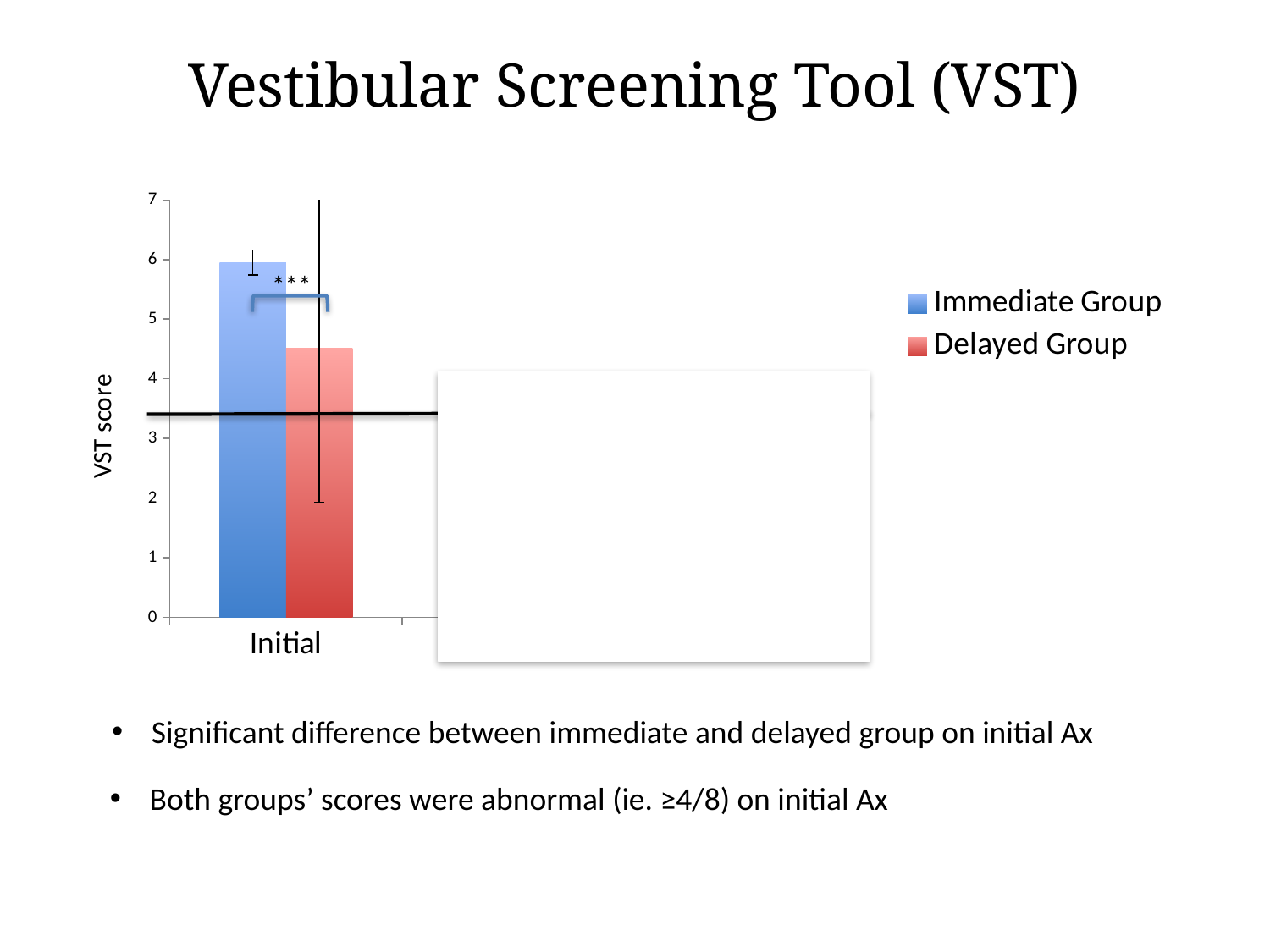
What is the label on the vertical axis? VST score Is the Immediate Group value for Initial greater or less than 7? less What kind of chart is shown on the slide? bar chart Is the Delayed Group value for Initial greater or less than 4? greater Which series is shown in blue? Immediate Group How many series does the legend list? 2 For the Initial category, which group has the higher VST score, Immediate Group or Delayed Group? Immediate Group Which two series are listed in the legend? Immediate Group and Delayed Group Is the Immediate Group value for Initial greater or less than 5? greater